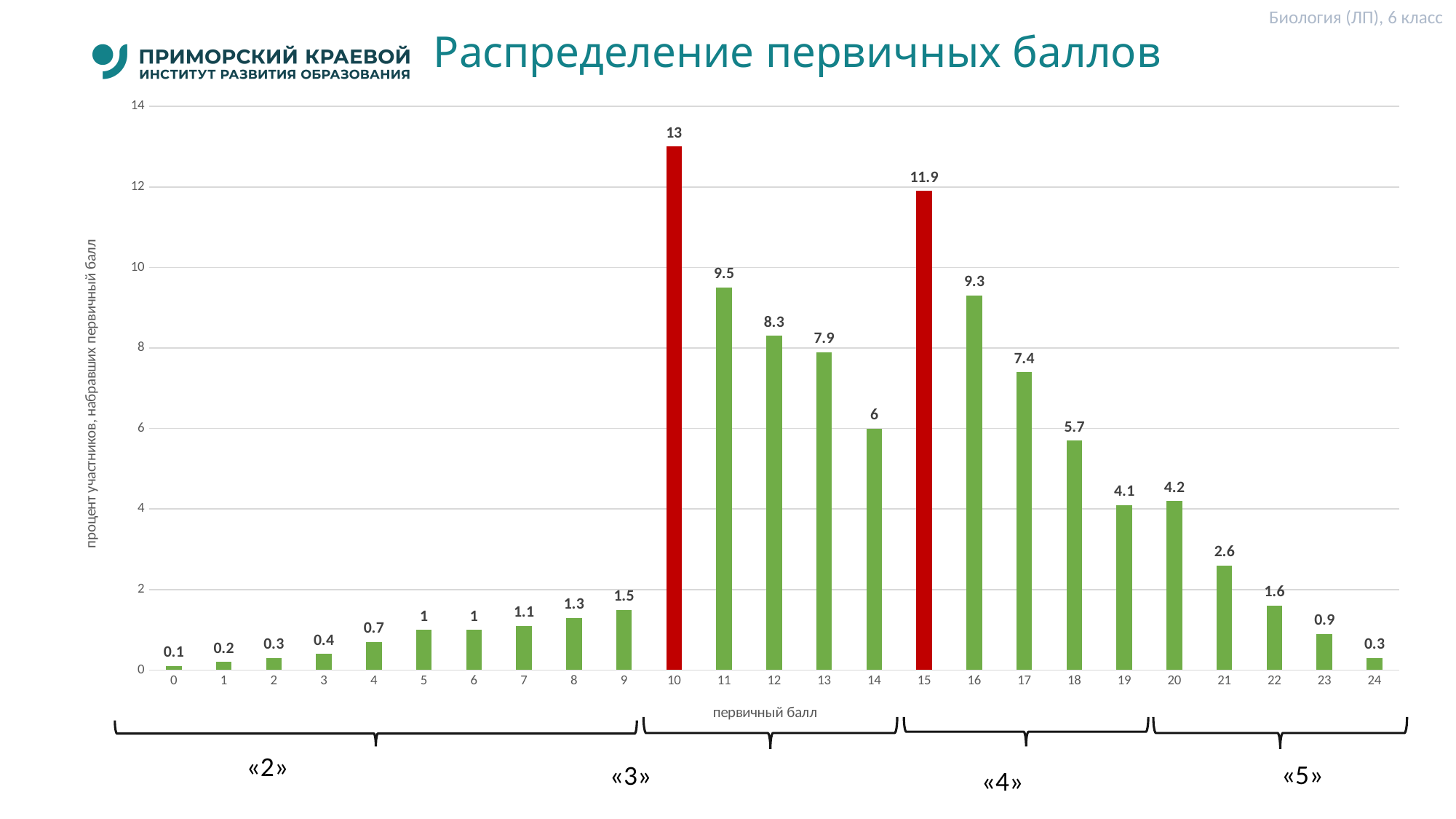
How many primary score categories are shown on the x axis? 25 Which primary score has the highest percentage of participants? 10 What is the value shown for primary score 17? 7.4 Which two bars are coloured red instead of green? 10 and 15 Which primary score has the lowest percentage of participants? 0 What is the value shown for primary score 15? 11.9 What is the difference between the values for primary scores 11 and 14? 3.5 What is the difference between the values for primary scores 10 and 15? 1.1 Which is larger, the value for primary score 16 or for primary score 12? 16 Do the values rise or fall from primary score 15 to primary score 24? fall What percentage of participants scored a primary score of 10? 13 What type of chart is shown on the slide? bar chart